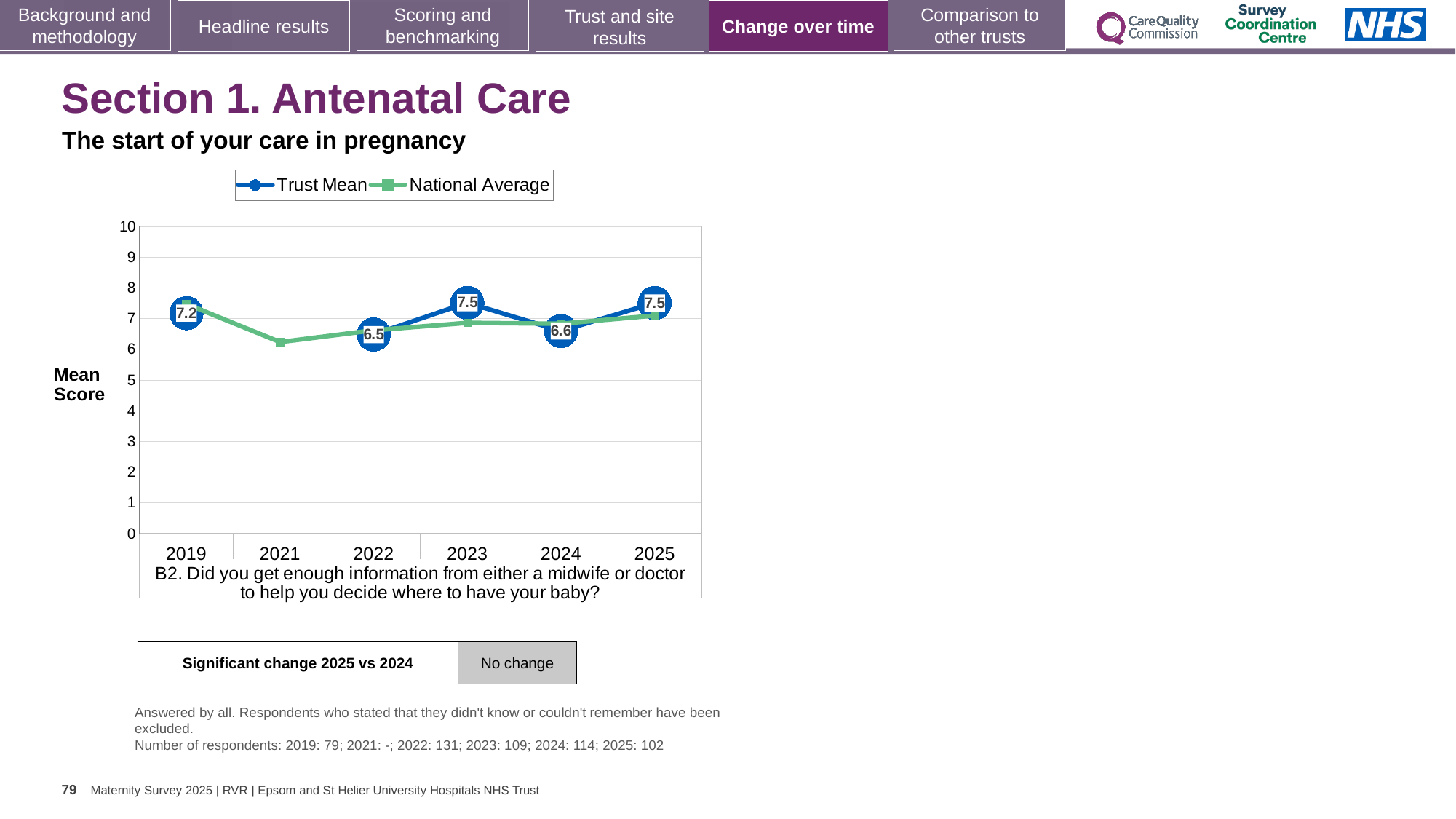
What is the Trust Mean value for 2024? 6.6 What is the difference between the Trust Mean in 2023 and in 2022? 1.0 How many series does the legend list? 2 Does the Trust Mean rise or fall from 2024 to 2025? rise Is the National Average value for 2021 greater or less than 7? less In which year is the Trust Mean lowest? 2022 How many years are shown on the x axis? 6 What is the Trust Mean value for 2019? 7.2 Which year has the larger Trust Mean, 2019 or 2024? 2019 What is the Trust Mean value for 2025? 7.5 What is the highest Trust Mean value shown on the chart? 7.5 What kind of chart is shown on the slide? line chart